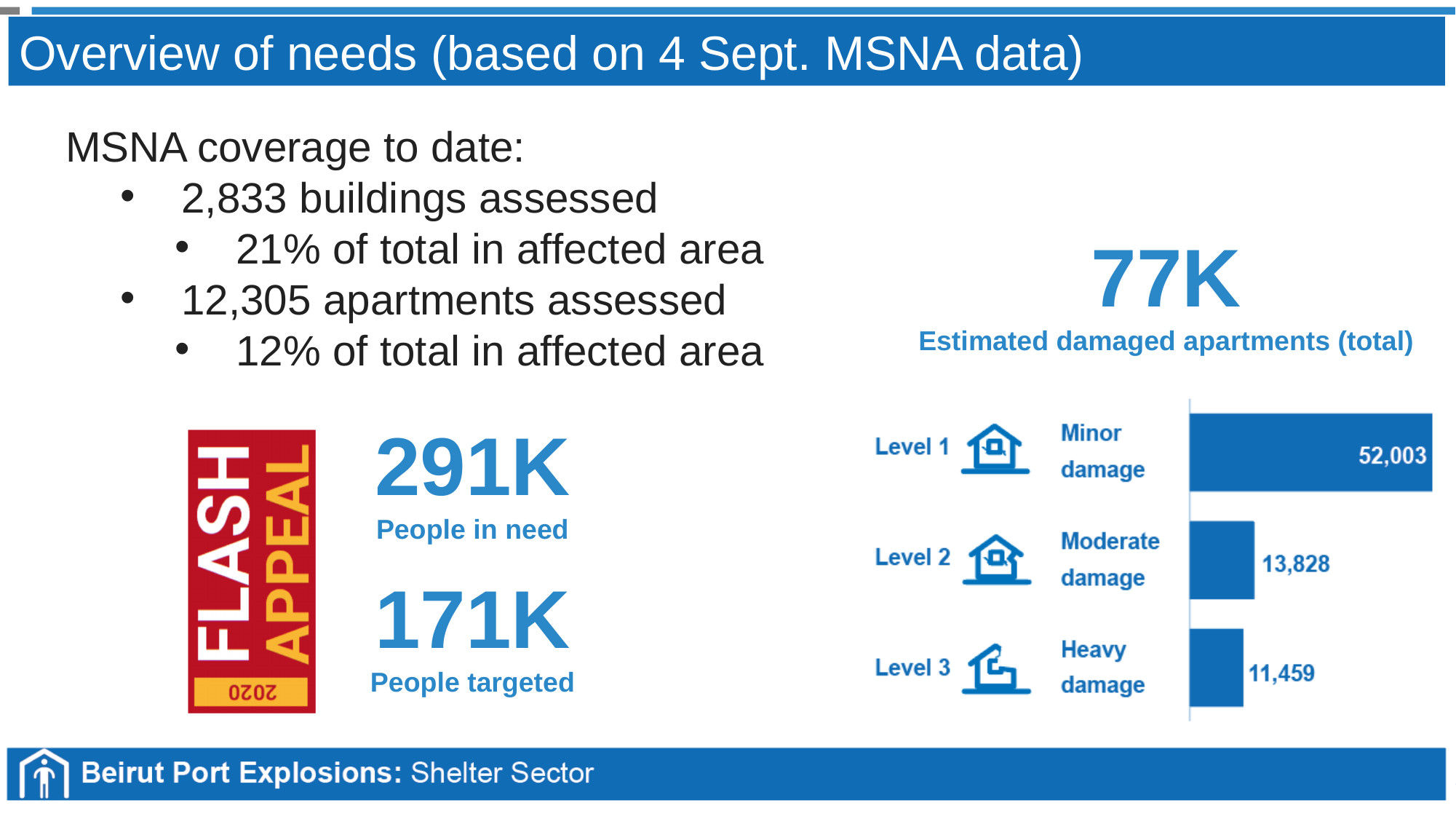
What kind of chart is used to show the damaged apartments by level? Bar chart Which is larger in the bar chart: Moderate damage or Heavy damage? Moderate damage Which damage level has the highest number of apartments in the bar chart? Level 1 (Minor damage) What is the difference between the Level 2 (Moderate damage) and Level 3 (Heavy damage) values in the bar chart? 2,369 What is the difference between the Level 1 (Minor damage) and Level 2 (Moderate damage) values in the bar chart? 38,175 Do the values in the bar chart rise or fall from Level 1 to Level 3? Fall What is the total estimated number of damaged apartments shown above the bar chart? 77K What is the value for Level 3 (Heavy damage) in the damaged apartments bar chart? 11,459 What is the value for Level 2 (Moderate damage) in the damaged apartments bar chart? 13,828 What is the value for Level 1 (Minor damage) in the damaged apartments bar chart? 52,003 Which damage level has the lowest number of apartments in the bar chart? Level 3 (Heavy damage) How many damage levels are shown in the bar chart? 3